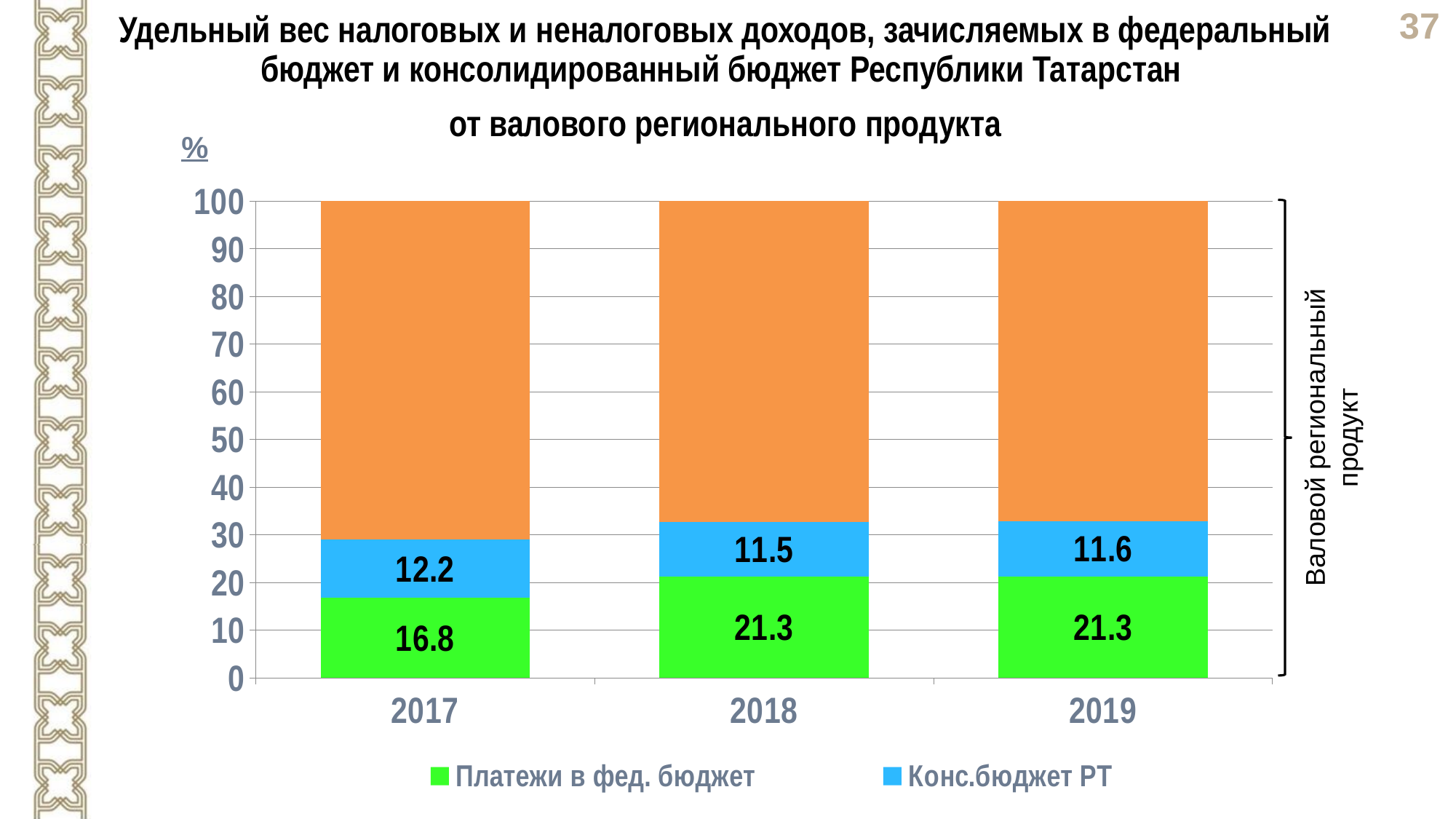
In 2017, which is larger: Платежи в фед. бюджет or Конс.бюджет РТ? Платежи в фед. бюджет How many years are shown on the x axis? 3 What is the value of Платежи в фед. бюджет for 2017? 16.8 In which year is the value of Платежи в фед. бюджет the lowest? 2017 By how much did Платежи в фед. бюджет increase from 2017 to 2018? 4.5 How many series does the legend list? 2 What kind of chart is shown on the slide? Stacked bar chart What is the value of Конс.бюджет РТ for 2018? 11.5 In which year is the value of Конс.бюджет РТ the highest? 2017 What is the difference between Конс.бюджет РТ in 2017 and in 2018? 0.7 What is the combined value of the two labelled segments (Платежи в фед. бюджет and Конс.бюджет РТ) for 2017? 29.0 What is the value of Конс.бюджет РТ for 2019? 11.6